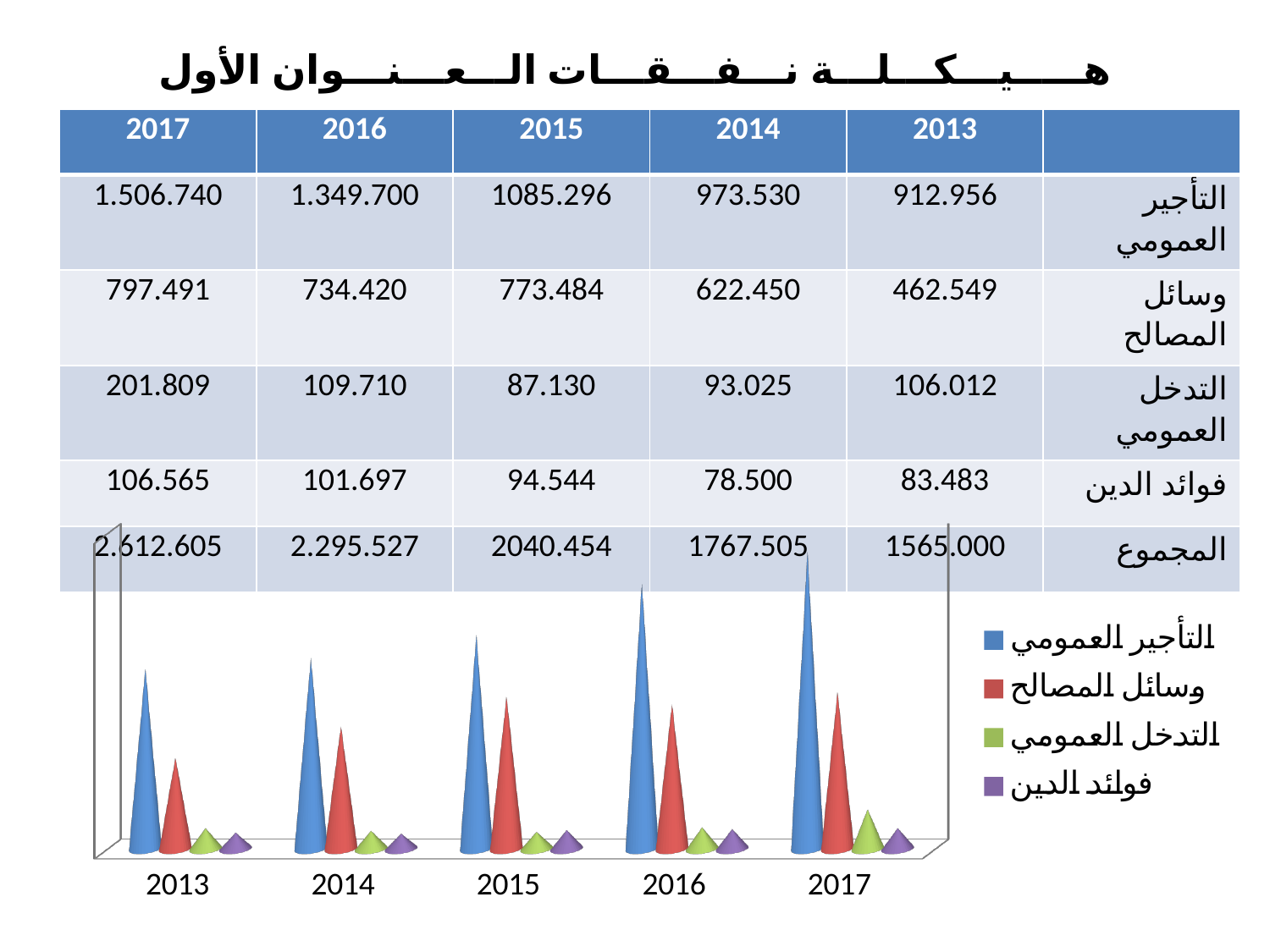
In 2017, which is larger in the chart: التأجير العمومي or وسائل المصالح? التأجير العمومي According to the table above the chart, what is the value of فوائد الدين for 2014? 78.500 According to the table above the chart, what is the value of التأجير العمومي for 2017? 1.506.740 Which series is shown in purple in the chart's legend? فوائد الدين What kind of chart is shown at the bottom of the slide? bar chart Do the values for التأجير العمومي rise or fall from 2013 to 2017 in the chart? rise How many years are shown along the x axis of the chart? 5 How many series does the chart's legend list? 4 In which year is the value for التأجير العمومي highest in the chart? 2017 In which year is the value for التأجير العمومي lowest in the chart? 2013 Which series is shown in blue in the chart's legend? التأجير العمومي In 2017, which is larger in the chart: التدخل العمومي or فوائد الدين? التدخل العمومي